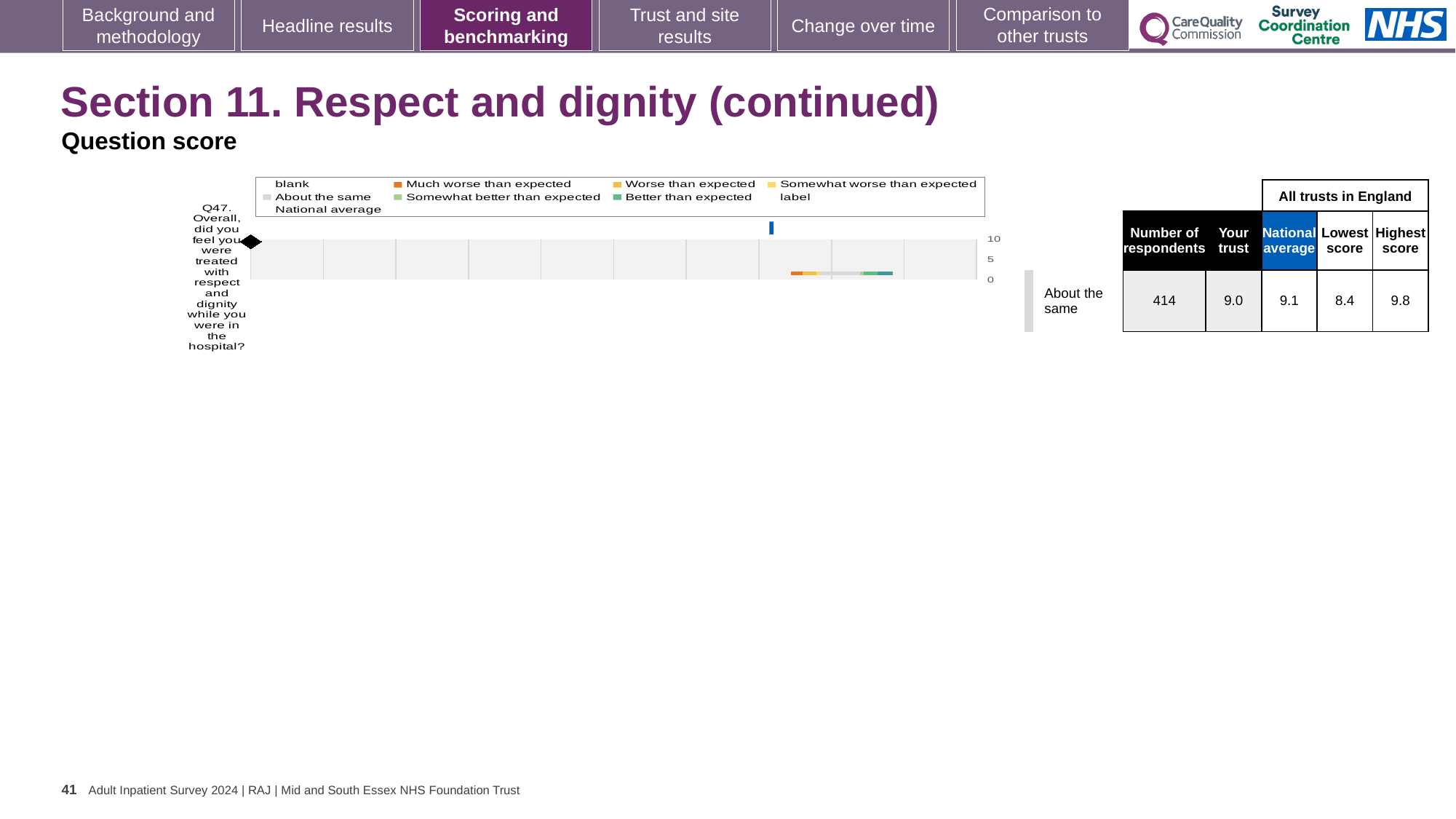
What is the lowest score among all trusts in England for Q47? 8.4 What is the highest score among all trusts in England for Q47? 9.8 By how much does the national average exceed the 'Your trust' score for Q47? 0.1 Which question number is plotted on the chart? Q47 What is the national average score for Q47 shown on the slide? 9.1 What is the 'Your trust' score for Q47 shown on the slide? 9.0 Which benchmark category is the trust's Q47 result placed in? About the same How many respondents answered Q47? 414 What is the difference between the highest score and the lowest score for Q47? 1.4 What is the highest tick value shown on the chart's score axis? 10 Which is larger for Q47, the 'Your trust' score or the national average? National average What kind of chart is shown on the slide? Bar chart